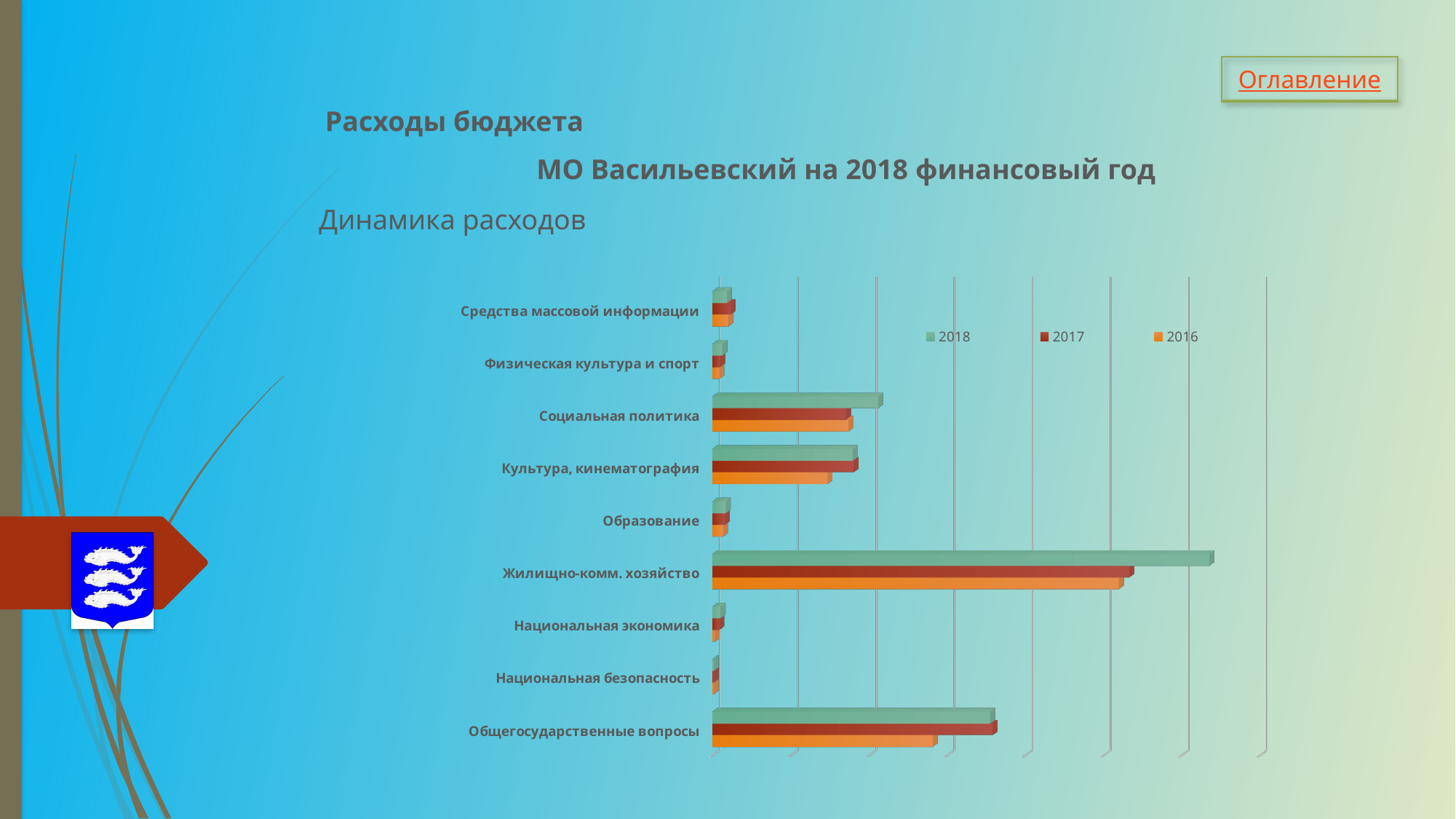
Which is larger: the 2018 value for Общегосударственные вопросы or the 2018 value for Социальная политика? Общегосударственные вопросы How many categories are plotted on the chart? 9 Which category has the highest value for 2016? Жилищно-комм. хозяйство For Культура, кинематография, which is larger: the 2018 value or the 2016 value? 2018 For Социальная политика, which is larger: the 2018 value or the 2017 value? 2018 Which category has the highest value for 2018? Жилищно-комм. хозяйство Which years are listed in the chart's legend? 2018, 2017, 2016 How many series does the chart's legend list? 3 What is the heading shown above the chart? Динамика расходов What kind of chart is shown on the slide? bar chart